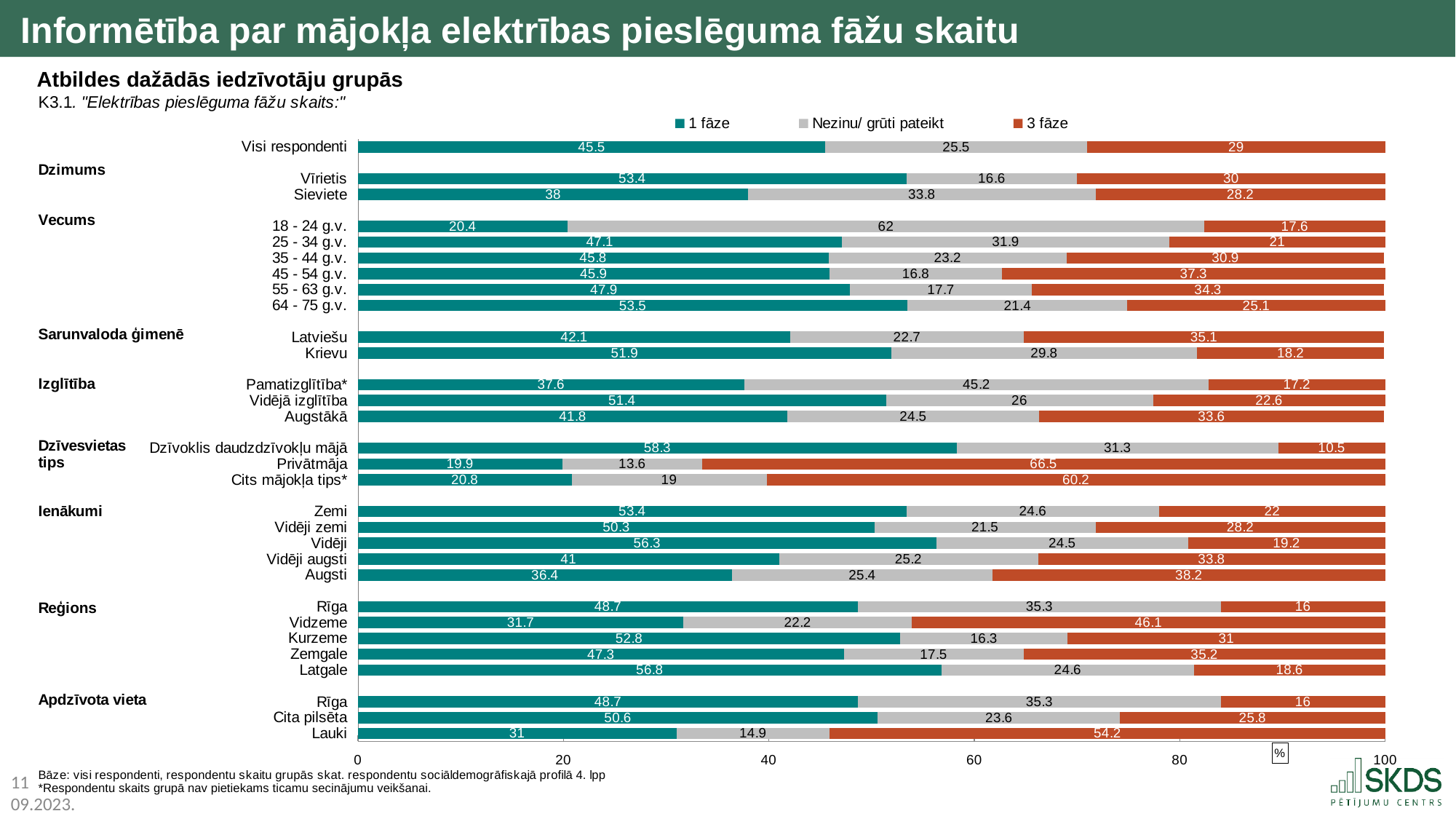
What is the difference between the "1 fāze" values for Vīrietis and Sieviete? 15.4 How many series does the legend list? 3 Which category has the lowest "3 fāze" value? Dzīvoklis daudzdzīvokļu mājā What is the value of "1 fāze" for Visi respondenti? 45.5 Which category has the highest "Nezinu/ grūti pateikt" value? 18 - 24 g.v. What is the value of "Nezinu/ grūti pateikt" for Vidzeme? 22.2 How many categories are listed under Reģions? 5 Which category has the highest "1 fāze" value? Dzīvoklis daudzdzīvokļu mājā What is the total of the stacked bar for Visi respondenti? 100 Which has the larger "3 fāze" value, Latviešu or Krievu? Latviešu What is the value of "3 fāze" for Privātmāja? 66.5 What kind of chart is shown on the slide? Stacked bar chart